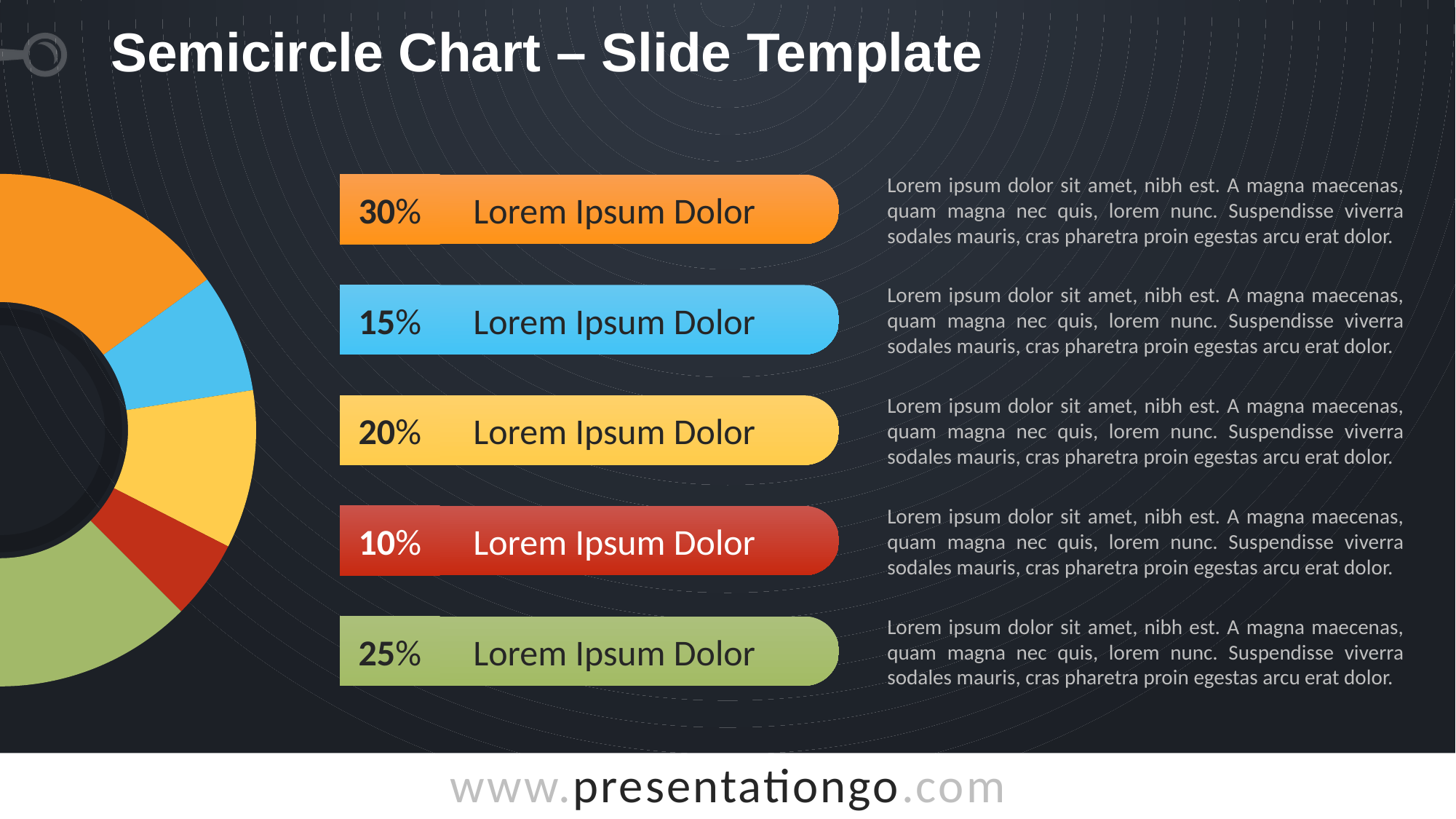
How many segments does the semicircle chart have? 5 What is the difference between the orange segment's percentage and the red segment's percentage? 20% Which colour segment has the smallest percentage? Red (10%) What percentage is shown for the yellow segment? 20% Which is larger, the green segment's percentage or the yellow segment's percentage? Green (25%) What percentage is shown for the red segment? 10% What do the five segment percentages add up to? 100% What percentage is shown for the green segment? 25% What kind of chart is shown on the slide? Semicircle (half donut) chart What percentage is shown for the orange segment? 30% What percentage is shown for the blue segment? 15% Which colour segment has the largest percentage? Orange (30%)